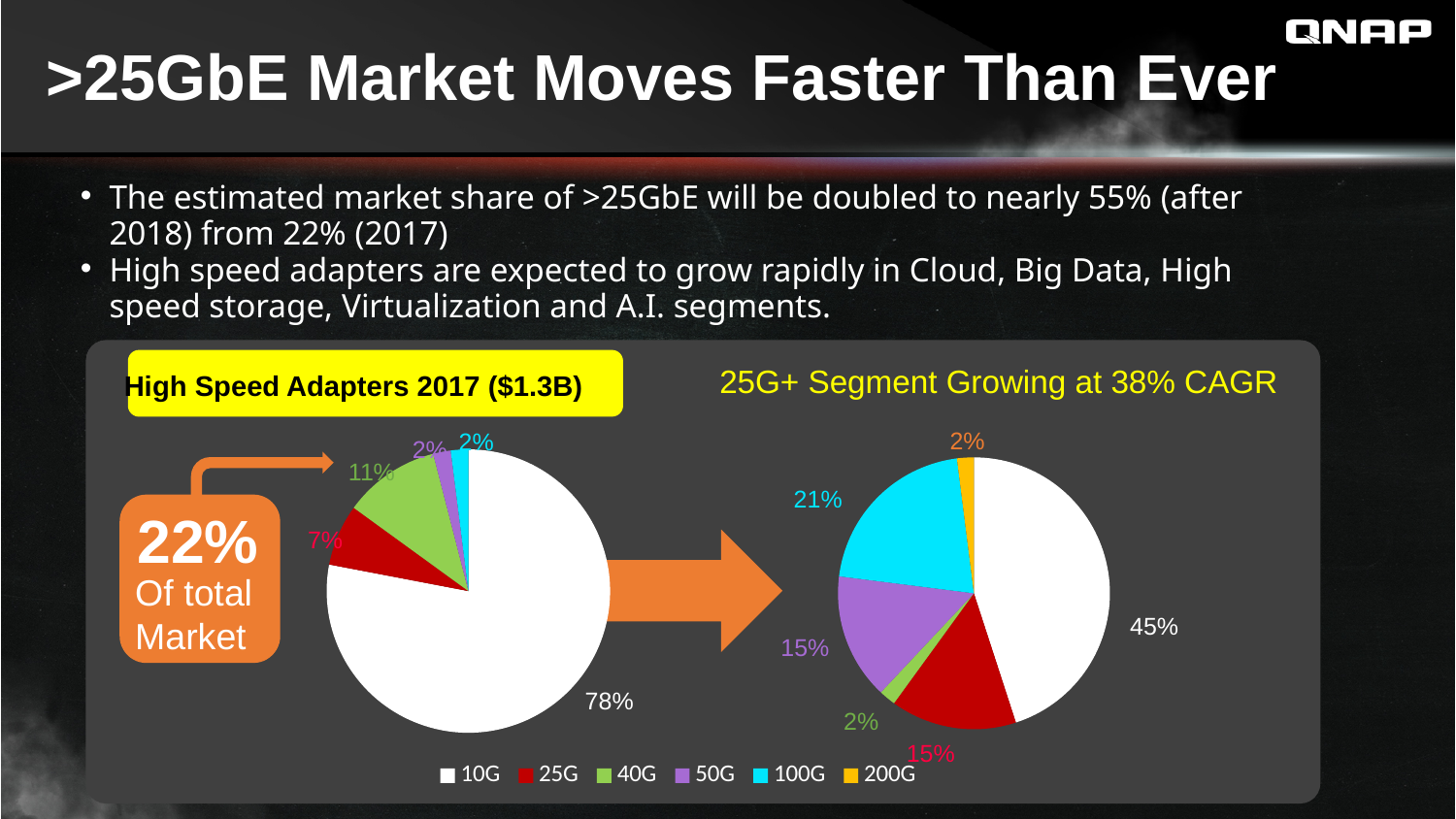
What is the difference between the 10G share in the left pie chart and the 10G share in the right pie chart? 33% In the right pie chart (25G+ Segment Growing at 38% CAGR), what share does 10G hold? 45% How many series does the legend list? 6 In the left pie chart (High Speed Adapters 2017), what share does 25G hold? 7% In the right pie chart, which segment has the largest share? 10G In the right pie chart, which is larger: the 100G share or the 25G share? 100G In the left pie chart (High Speed Adapters 2017), what share does 40G hold? 11% In the right pie chart (25G+ Segment Growing at 38% CAGR), what share does 100G hold? 21% What type of charts are shown on the slide? Pie charts In the right pie chart (25G+ Segment Growing at 38% CAGR), what share does 200G hold? 2% In the left pie chart, which segment has the largest share? 10G In the left pie chart (High Speed Adapters 2017), what share does 10G hold? 78%